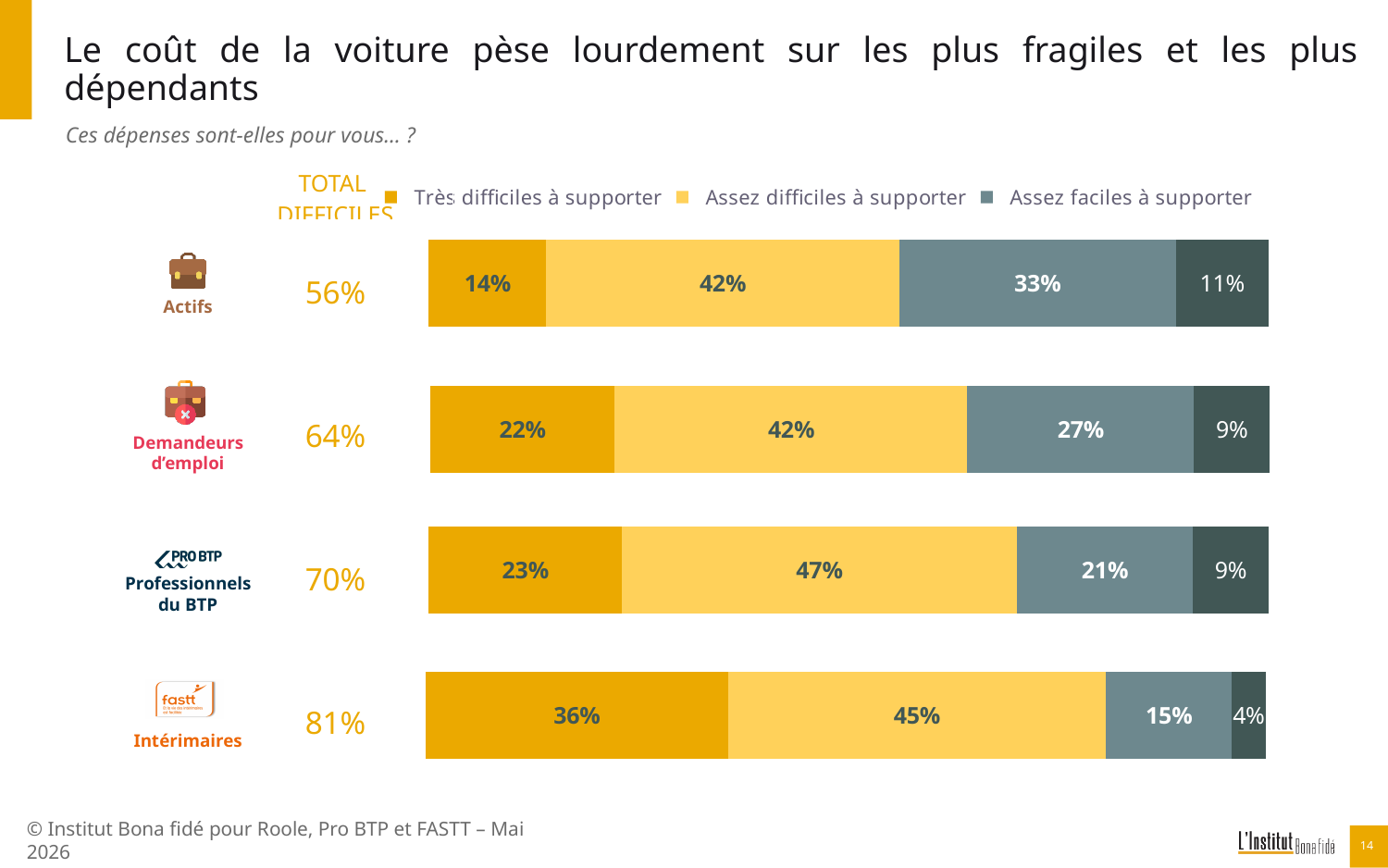
What type of chart is shown on the slide? Stacked bar chart What is the difference in percentage points between the "Très difficiles à supporter" share for Intérimaires and for Actifs? 22 percentage points How many groups (categories) are shown in the chart? 4 Which group has the highest share answering "Très difficiles à supporter"? Intérimaires What percentage of Actifs find these expenses "Assez faciles à supporter"? 33% Which group has a larger "Assez faciles à supporter" share, Actifs or Demandeurs d'emploi? Actifs What percentage of Professionnels du BTP find these expenses "Assez difficiles à supporter"? 47% What percentage of Intérimaires find these expenses "Très difficiles à supporter"? 36% What is the TOTAL DIFFICILES value for Intérimaires? 81% What is the combined share of "Très difficiles à supporter" and "Assez difficiles à supporter" for Professionnels du BTP? 70% Which group has the lowest TOTAL DIFFICILES value? Actifs What is the TOTAL DIFFICILES value for Demandeurs d'emploi? 64%